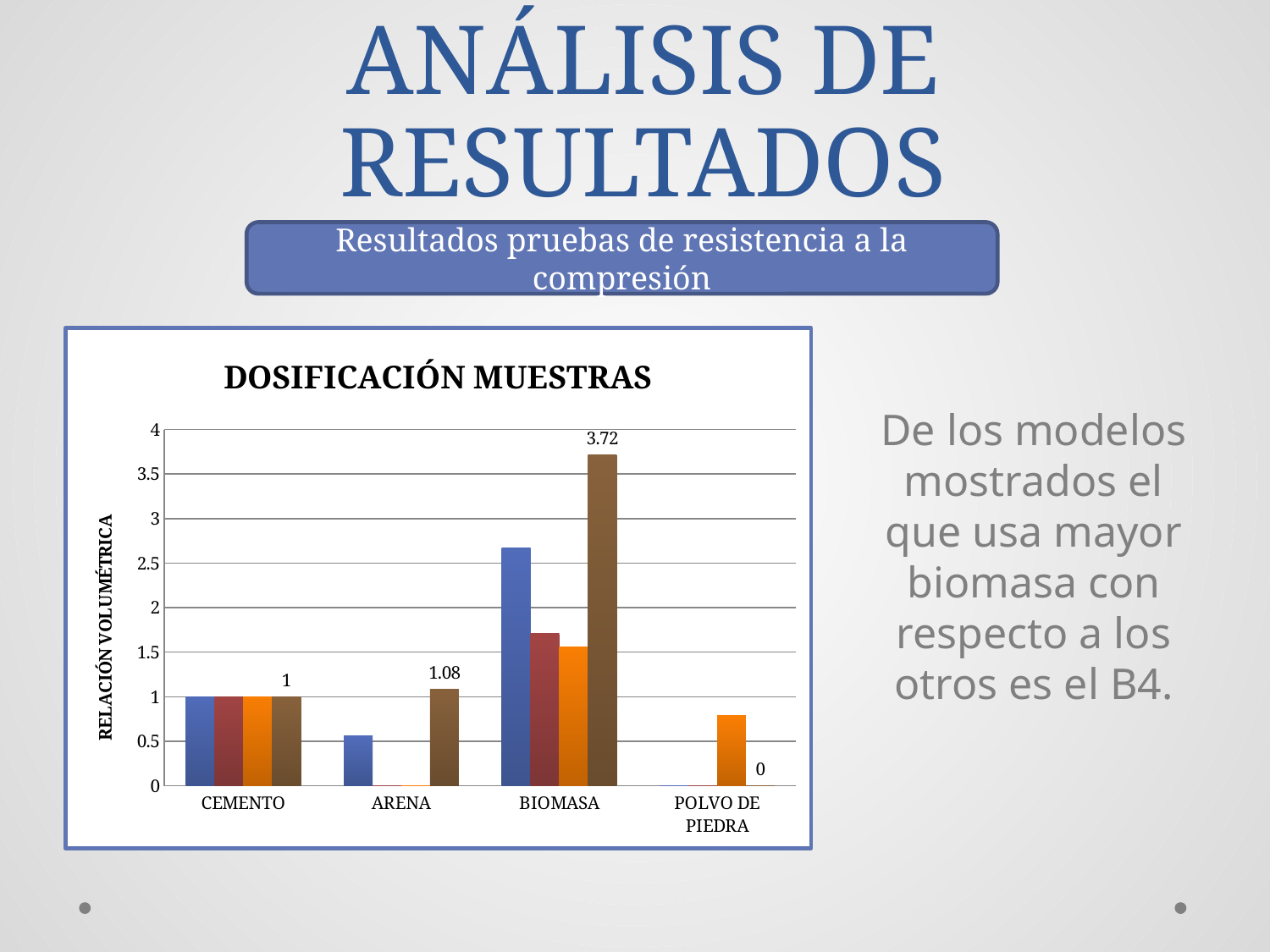
What is the title of the chart? DOSIFICACIÓN MUESTRAS What is the labelled value of the brown bar for BIOMASA? 3.72 What is the label of the vertical axis of the chart? RELACIÓN VOLUMÉTRICA What kind of chart is shown on the slide? bar chart How many categories are shown on the x axis of the chart? 4 What is the difference between the labelled brown-bar values for BIOMASA and ARENA? 2.64 What is the labelled value shown for POLVO DE PIEDRA? 0 What is the labelled value of the brown bar for CEMENTO? 1 What is the labelled value of the brown bar for ARENA? 1.08 Is the value of the blue bar for ARENA greater or less than 1? less Is the value of the blue bar for BIOMASA greater or less than 2.5? greater Which category has the highest labelled value for the brown bars? BIOMASA